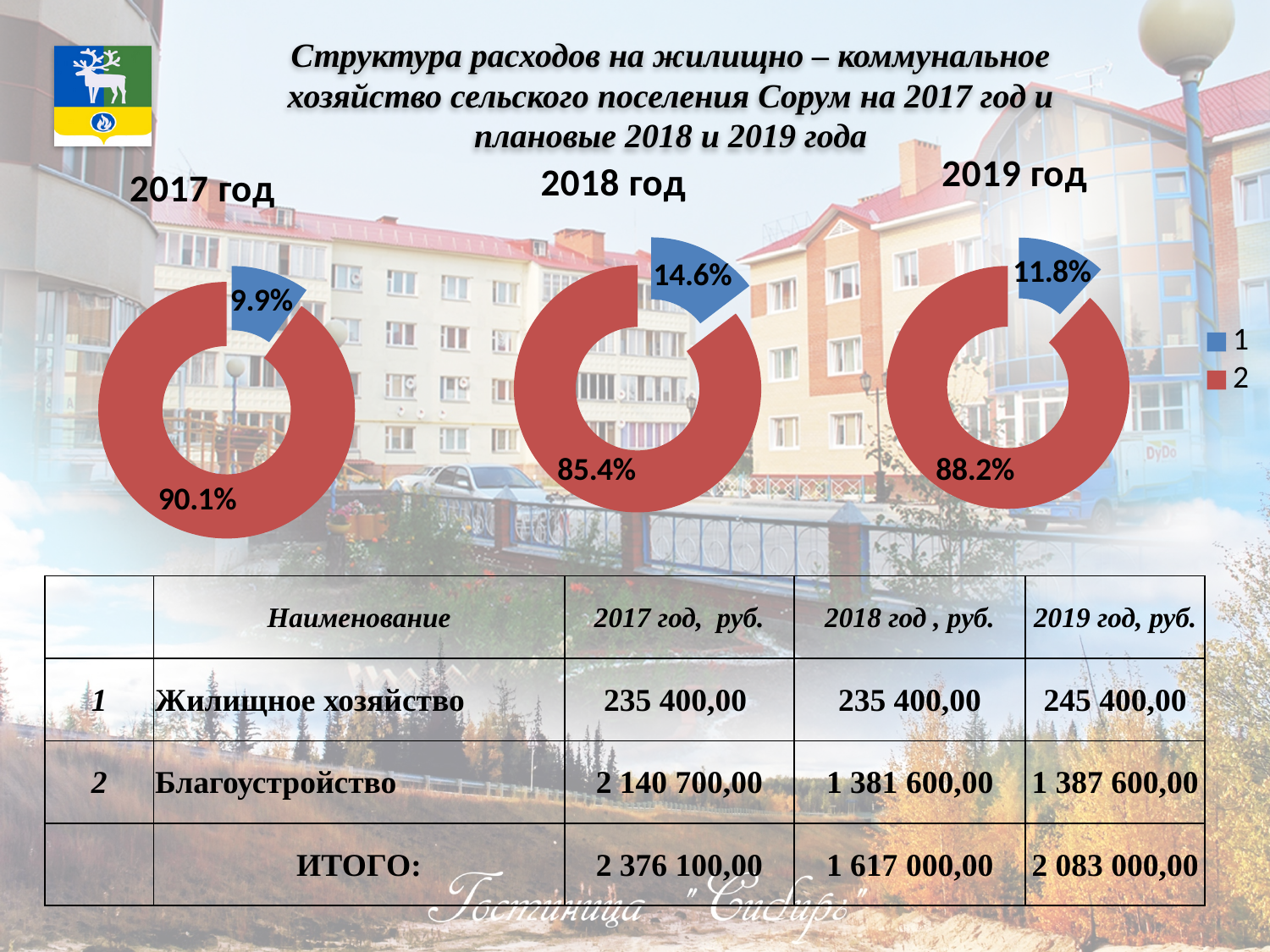
Across the three charts, in which year is the blue slice (series 1) the smallest? 2017 год In the 2017 год chart, what share does the red slice (series 2) have? 90.1% Across the three charts, in which year is the blue slice (series 1) the largest? 2018 год In the 2018 год chart, what is the difference between the red slice and the blue slice? 70.8% How many slices does the 2019 год chart have? 2 In the 2019 год chart, what is the difference between the red slice and the blue slice? 76.4% What kind of chart is used for the 2017 год, 2018 год and 2019 год data? Doughnut (pie) chart In the 2019 год chart, what share does the blue slice (series 1) have? 11.8% How many entries does the legend on the right list? 2 In the 2018 год chart, what share does the red slice (series 2) have? 85.4% In the 2018 год chart, which slice is larger, series 1 or series 2? 2 In the 2017 год chart, what share does the blue slice (series 1) have? 9.9%